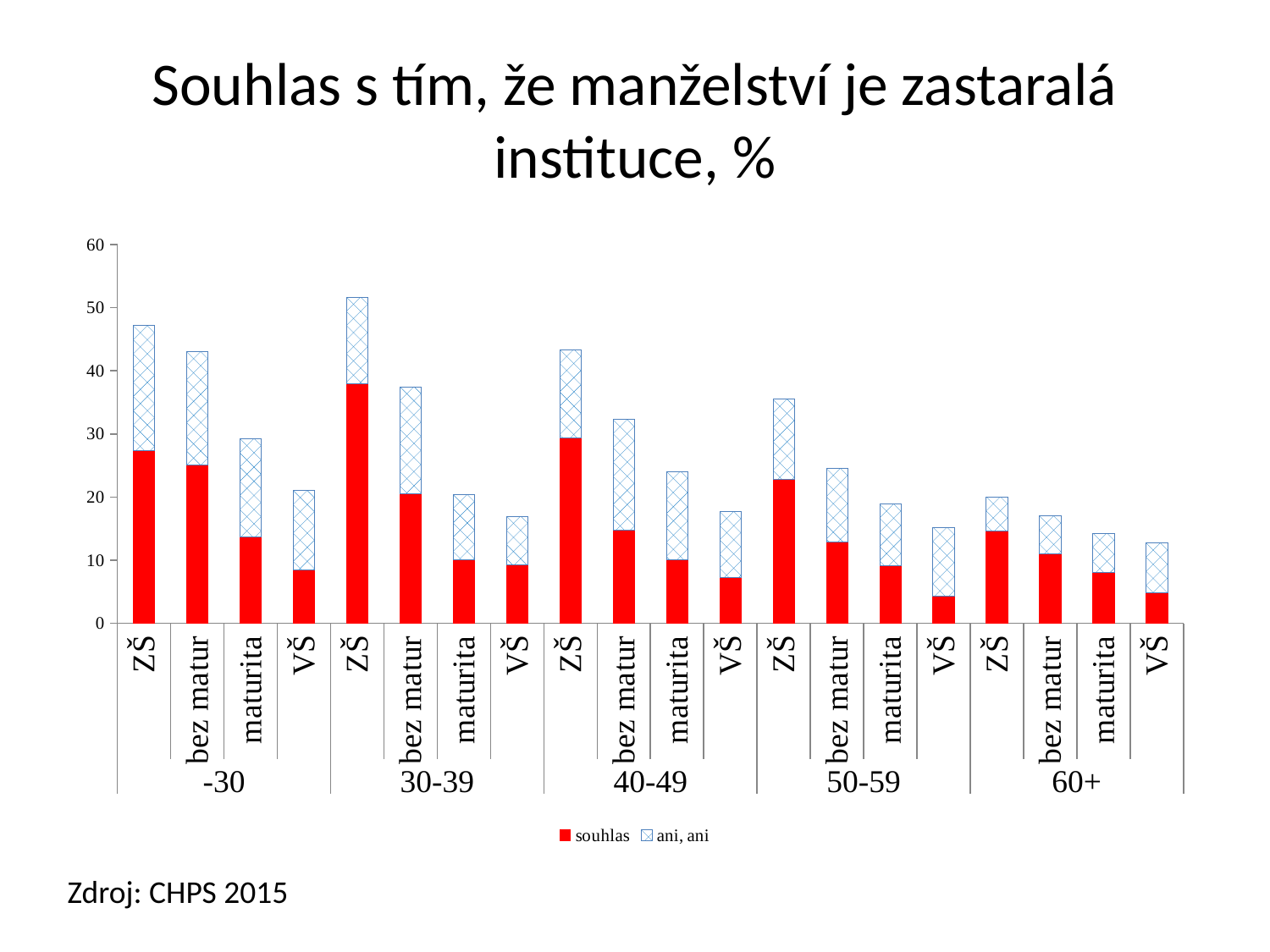
Is the total height of the ZŠ bar in the -30 group greater or less than 40? greater Which is larger, the 'souhlas' value for ZŠ in the -30 group or for ZŠ in the 60+ group? ZŠ in the -30 group Is the 'souhlas' value for ZŠ in the 30-39 group greater or less than 30? greater Within each age group, do the 'souhlas' values rise or fall from ZŠ to VŠ? fall What kind of chart is shown on the slide? stacked bar chart How many series does the legend list? 2 How many bars are plotted in total on the chart? 20 Is the 'souhlas' value for VŠ in the 50-59 group greater or less than 10? less What are the two series named in the legend? souhlas; ani, ani How many age groups are shown along the x axis? 5 Which bar has the highest 'souhlas' value? ZŠ in the 30-39 group